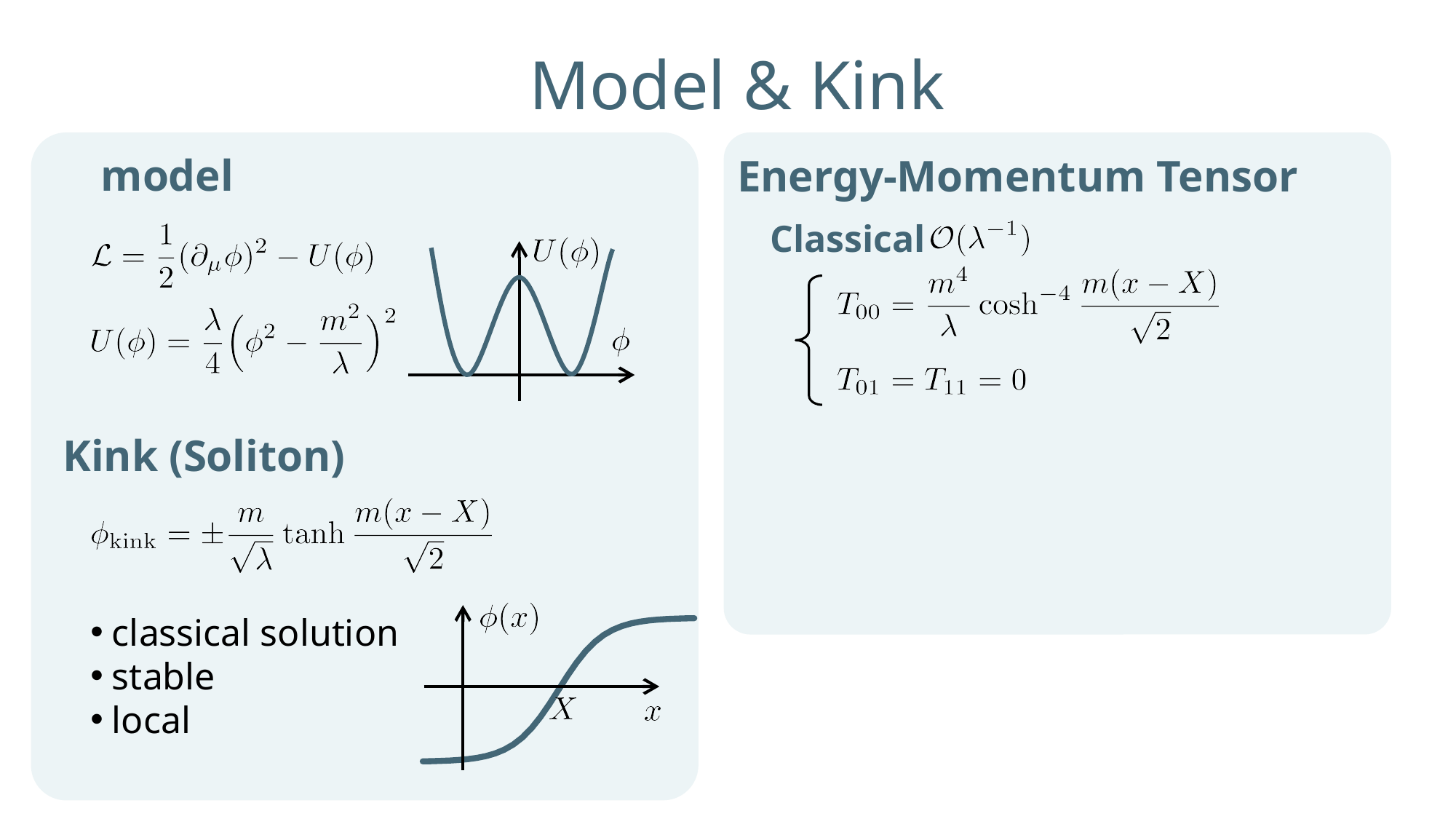
How many minima does the U(φ) curve in the model section have? 2 What kind of chart is the plot labelled U(φ) in the model section? line chart How many plots are shown on the slide? 2 What is the label on the horizontal axis of the U(φ) plot? φ In the φ(x) plot in the Kink (Soliton) section, does the curve rise or fall as x increases? rise What label marks the point on the x axis where the kink curve crosses zero in the φ(x) plot? X